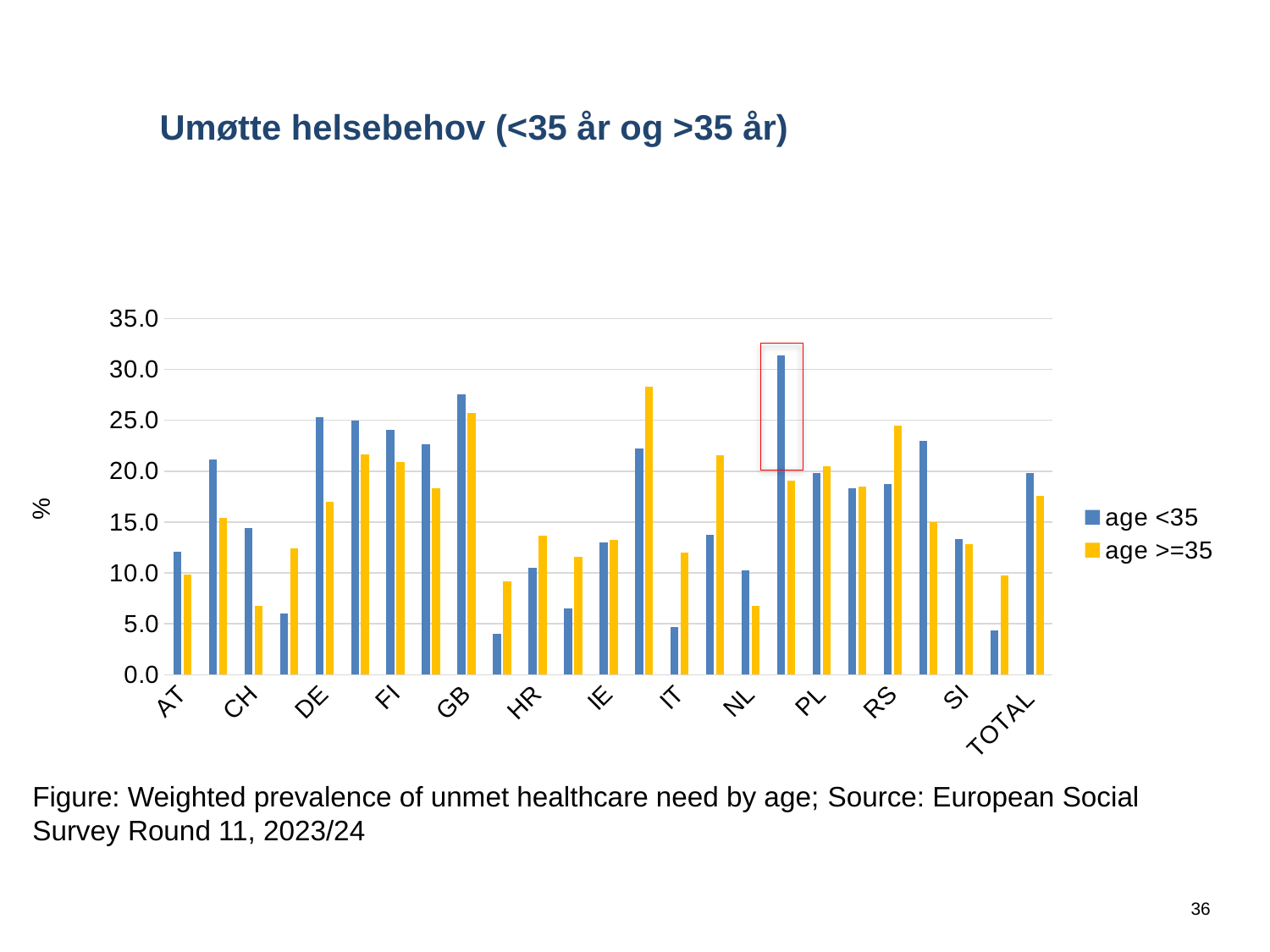
What is the label on the vertical axis? % Is the value for NL in the age >=35 series greater or less than 10.0? less What kind of chart is shown on the slide? bar chart Is the value for AT in the age <35 series greater or less than 10.0? greater How many series does the legend list? 2 For RS, which series has the larger value, age <35 or age >=35? age >=35 Is the value for TOTAL in the age >=35 series greater or less than 15.0? greater For CH, which series has the larger value, age <35 or age >=35? age <35 For IT, which series has the larger value, age <35 or age >=35? age >=35 What are the two series named in the legend? age <35 and age >=35